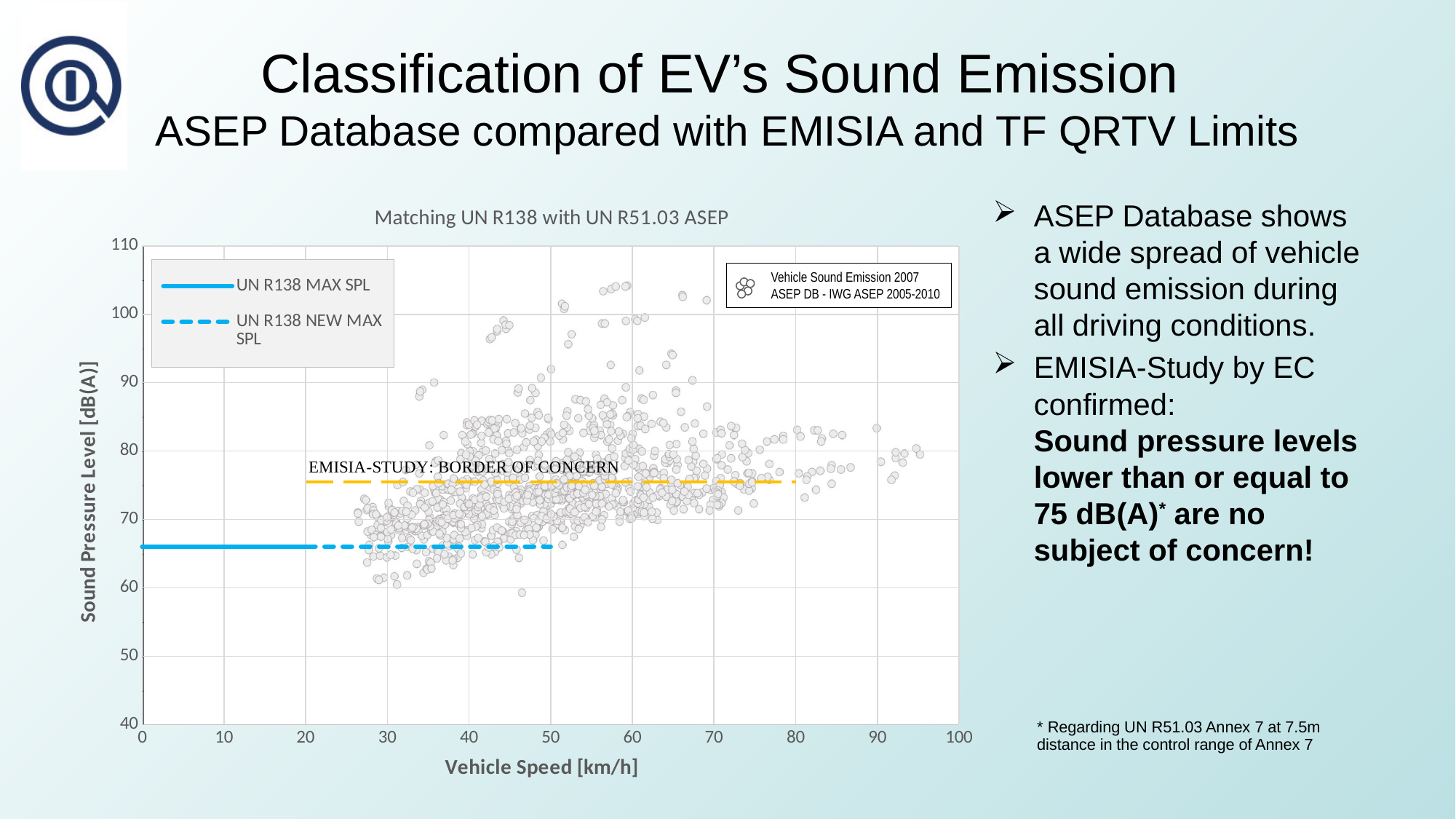
What kind of chart is shown on the slide? scatter chart Is the UN R138 MAX SPL line greater or less than 70 dB(A)? less Is the EMISIA-STUDY: BORDER OF CONCERN line greater or less than 80 dB(A)? less What is the label of the x axis of the chart? Vehicle Speed [km/h] Do the scattered sound pressure level points generally rise or fall as vehicle speed increases? rise What is the title of the chart? Matching UN R138 with UN R51.03 ASEP Is the EMISIA-STUDY: BORDER OF CONCERN line greater or less than 70 dB(A)? greater What is the highest value shown on the y axis of the chart? 110 How many series does the legend in the top-left of the chart list? 2 Which line is higher on the chart, the EMISIA-STUDY: BORDER OF CONCERN line or the UN R138 MAX SPL line? EMISIA-STUDY: BORDER OF CONCERN